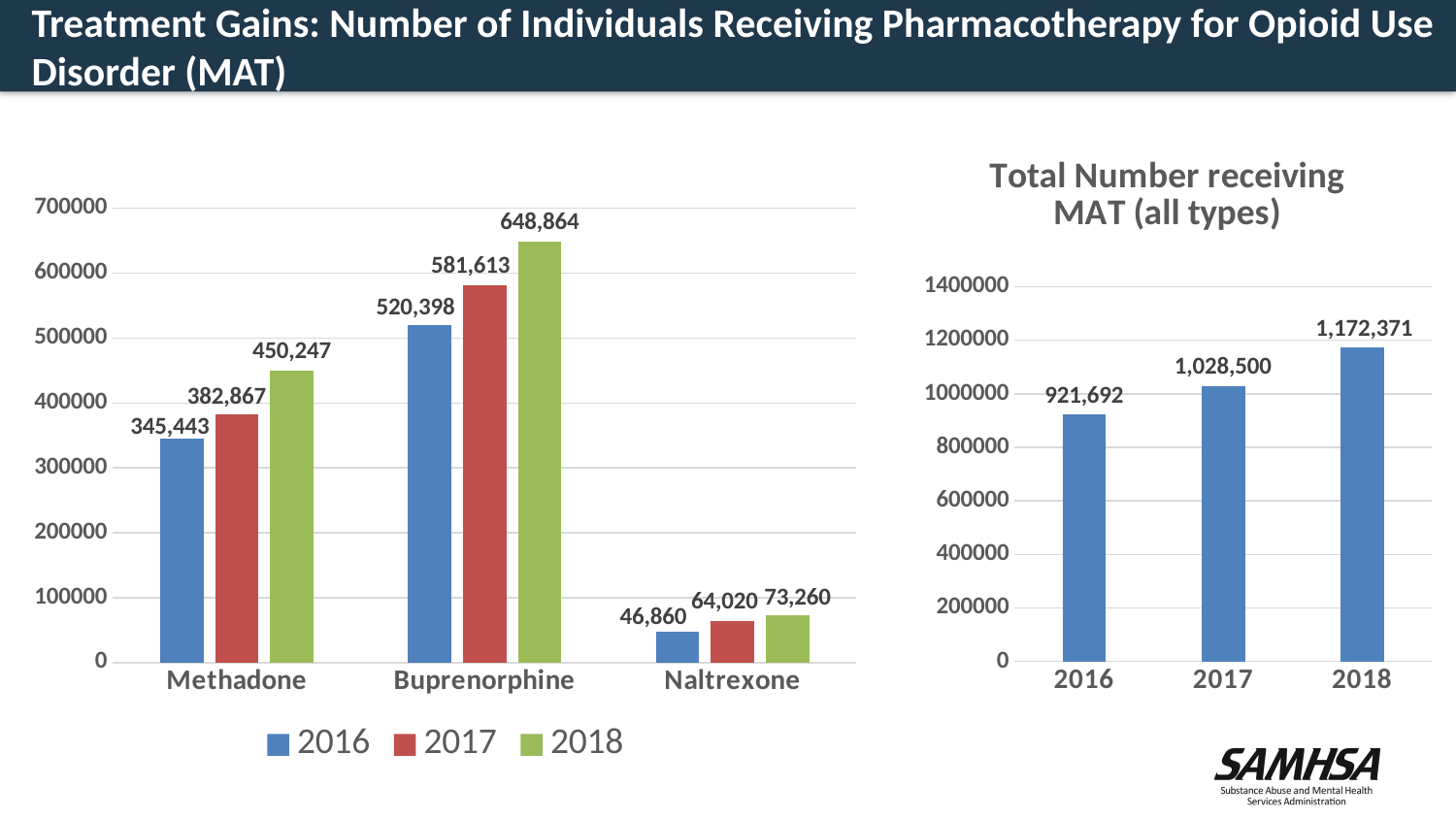
In the left chart, what is the difference between the Methadone values for 2018 and 2017? 67,380 In the left chart, how many medication categories are shown on the x axis? 3 In the left chart, which medication has the highest value in 2017? Buprenorphine In the left chart, what is the value for Methadone in 2016? 345,443 In the left chart, how many series does the legend list? 3 In the left chart, what is the value for Naltrexone in 2017? 64,020 In the 'Total Number receiving MAT (all types)' chart, what is the value for 2017? 1,028,500 In the 'Total Number receiving MAT (all types)' chart, do the values rise or fall from 2016 to 2018? rise What kind of chart is the 'Total Number receiving MAT (all types)' chart? bar chart In the 'Total Number receiving MAT (all types)' chart, what is the difference between the 2018 and 2016 values? 250,679 In the left chart, what is the value for Buprenorphine in 2018? 648,864 In the left chart, which medication has the lowest value in 2018? Naltrexone